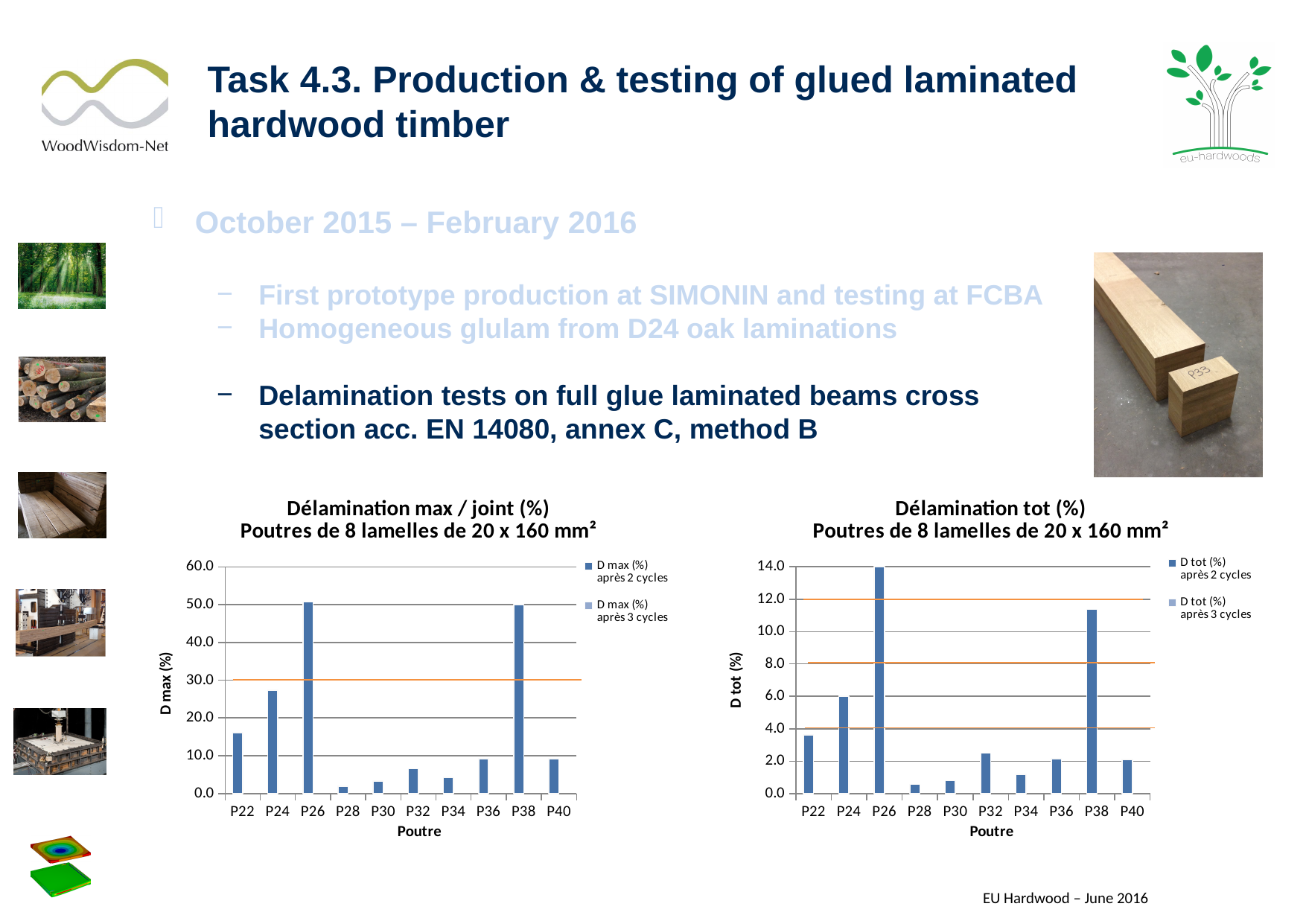
In the right chart 'Délamination tot (%)', is the value for P24 greater or less than 8.0? less In the right chart 'Délamination tot (%)', which beam has the highest value? P26 In the left chart 'Délamination max / joint (%)', is the value for P22 greater or less than 20.0? less What kind of chart is the left chart titled 'Délamination max / joint (%)'? bar chart In the left chart 'Délamination max / joint (%)', which beam has the lowest value? P28 In the right chart 'Délamination tot (%)', is the value for P38 greater or less than 10.0? greater In the right chart 'Délamination tot (%)', which is larger, the value for P24 or the value for P38? P38 What is the x-axis title of the left chart 'Délamination max / joint (%)'? Poutre How many beams (Poutre categories) are shown on the x axis of the right chart 'Délamination tot (%)'? 10 How many series does the legend of the left chart 'Délamination max / joint (%)' list? 2 In the left chart 'Délamination max / joint (%)', which is larger, the value for P22 or the value for P24? P24